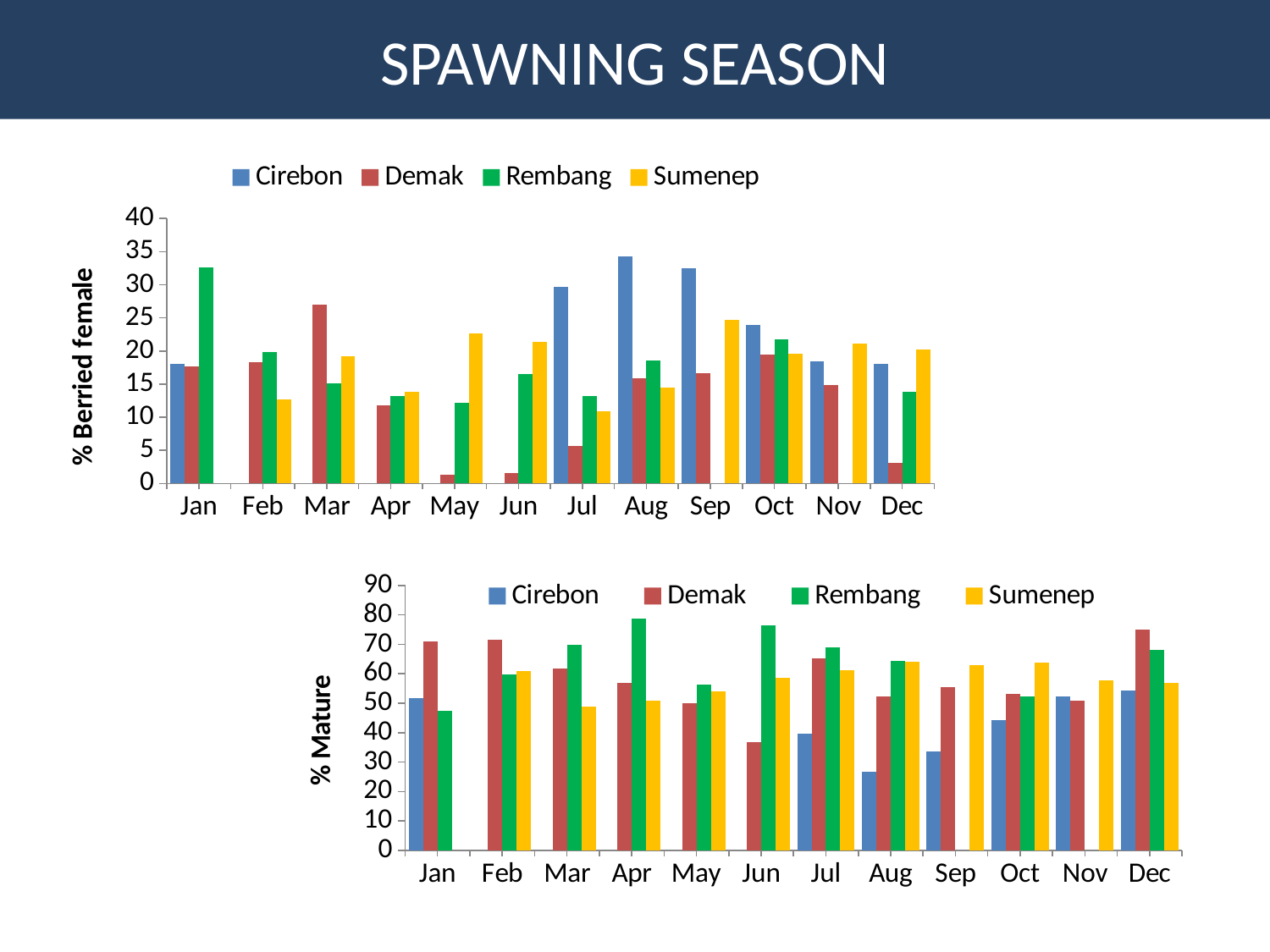
In the top chart (% Berried female), which series has the highest bar in Jan? Rembang In the top chart (% Berried female), is the value for Demak in May greater or less than 5? less How many months are shown on the x axis of the bottom chart (% Mature)? 12 In the bottom chart (% Mature), in which month is the Cirebon bar lowest? Aug What kind of chart is the top chart (% Berried female)? bar chart In the top chart (% Berried female), is the value for Cirebon in Aug greater or less than 30? greater In the bottom chart (% Mature), which is larger in Jun: Rembang or Demak? Rembang What is the y-axis title of the bottom chart? % Mature In the bottom chart (% Mature), is the value for Rembang in Apr greater or less than 70? greater In the top chart (% Berried female), which is larger in Mar: Demak or Rembang? Demak How many series does the legend of the top chart (% Berried female) list? 4